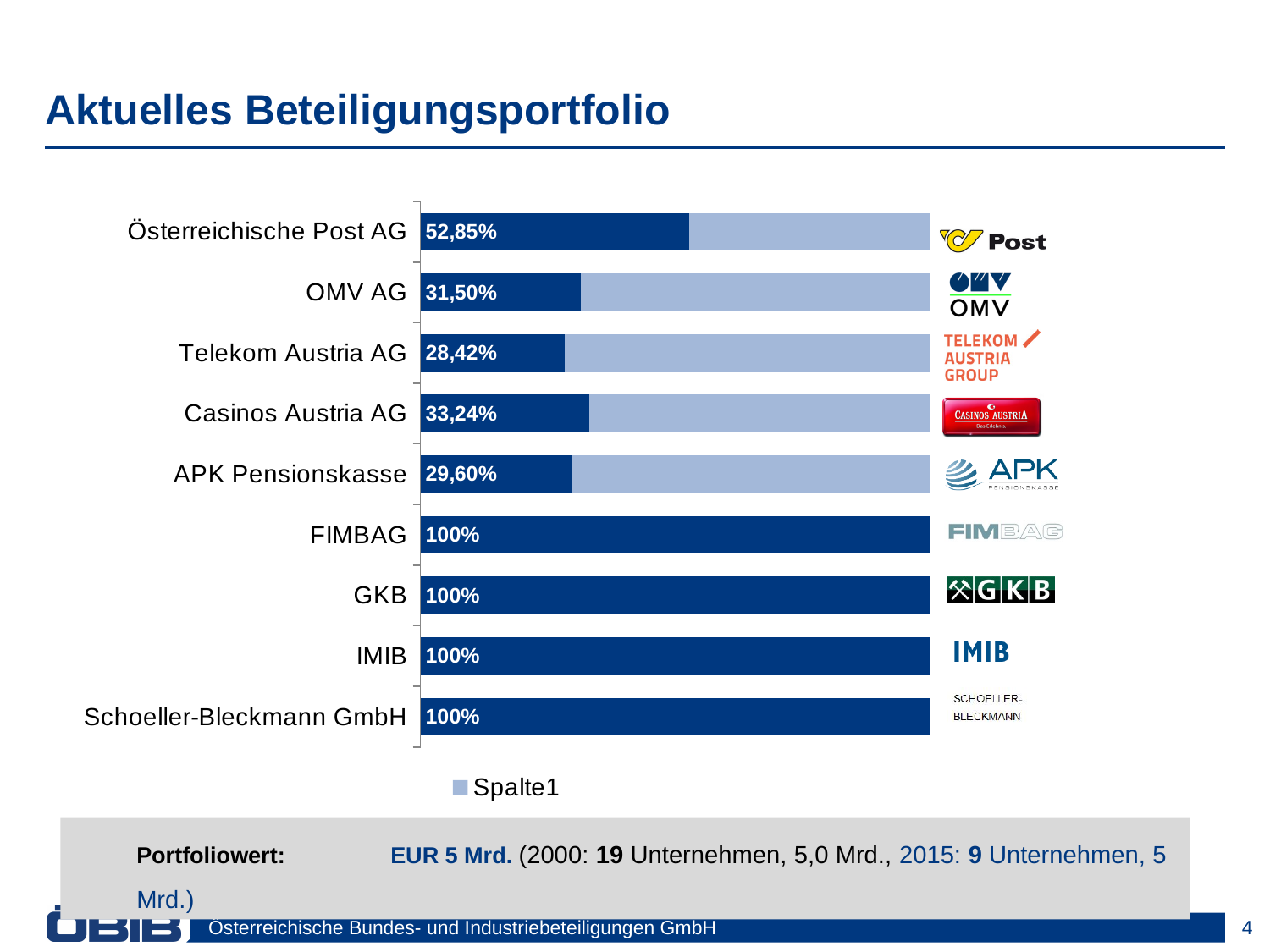
How many categories in the chart have a value of 100%? 4 What kind of chart is shown on the slide? Bar chart How many categories are shown in the chart? 9 What is the value shown for OMV AG? 31,50% What is the value shown for Österreichische Post AG? 52,85% Which category has the lowest value in the chart? Telekom Austria AG What is the value shown for APK Pensionskasse? 29,60% What is the value shown for GKB? 100% What is the difference between the values for Österreichische Post AG and OMV AG? 21,35% How many series does the legend list? 1 What is the value shown for Casinos Austria AG? 33,24% Which is larger, the value for Casinos Austria AG or the value for Telekom Austria AG? Casinos Austria AG